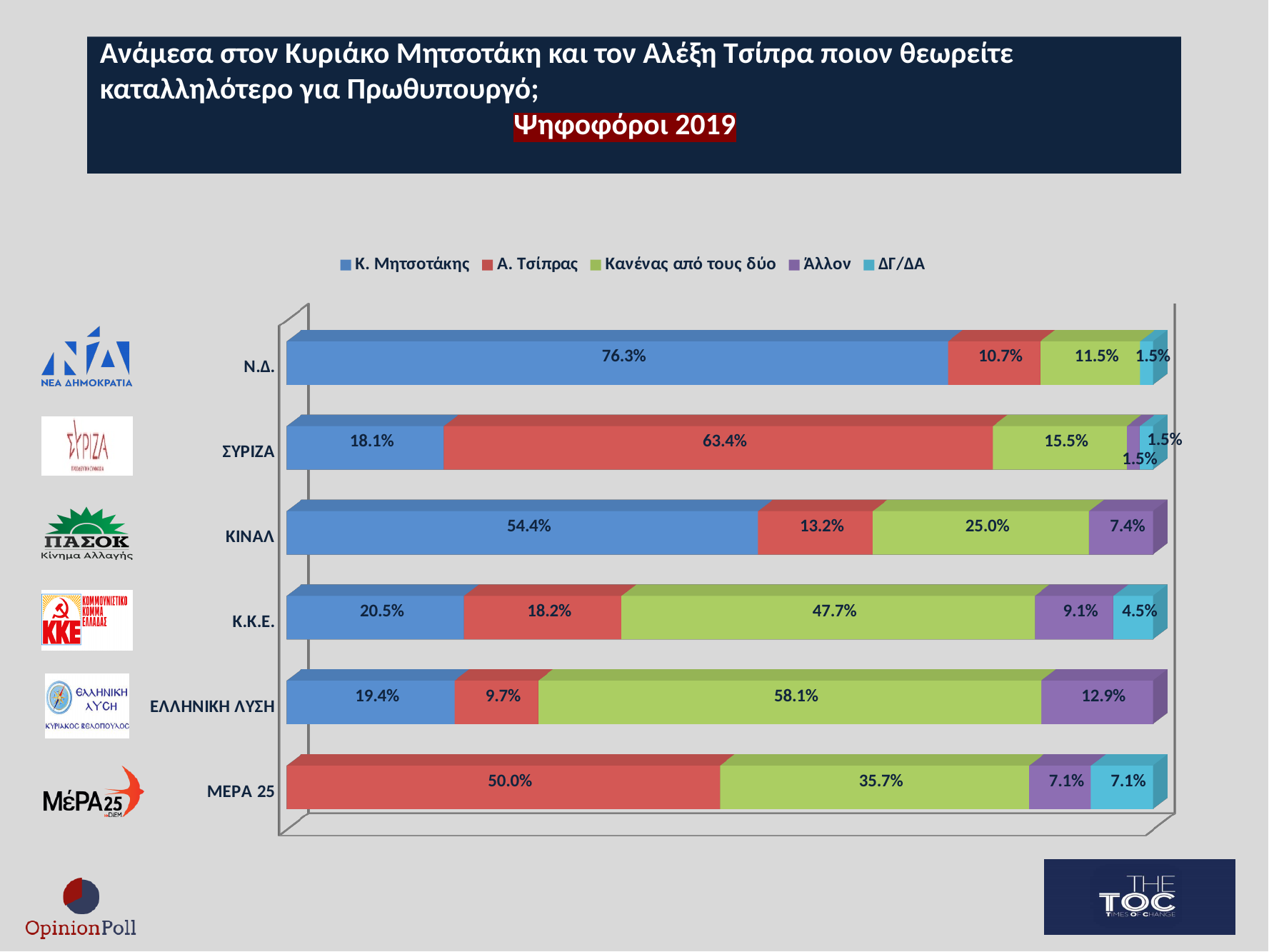
What is the value for Κανένας από τους δύο among ΕΛΛΗΝΙΚΗ ΛΥΣΗ voters? 58.1% How many party categories are shown on the chart? 6 What is the value for Α. Τσίπρας among ΣΥΡΙΖΑ voters? 63.4% Which party's voters have the highest value for Κ. Μητσοτάκης? Ν.Δ. How many series does the legend list? 5 What kind of chart is shown on the slide? Stacked bar chart Which party's voters have the lowest value for Α. Τσίπρας? ΕΛΛΗΝΙΚΗ ΛΥΣΗ What is the difference between the Κ. Μητσοτάκης value for Ν.Δ. voters and for ΚΙΝΑΛ voters? 21.9% Which series is shown in green in the legend? Κανένας από τους δύο What is the value for Κ. Μητσοτάκης among Ν.Δ. voters? 76.3% Among Κ.Κ.Ε. voters, which is larger: the value for Κ. Μητσοτάκης or for Α. Τσίπρας? Κ. Μητσοτάκης What is the value for Άλλον among Κ.Κ.Ε. voters? 9.1%